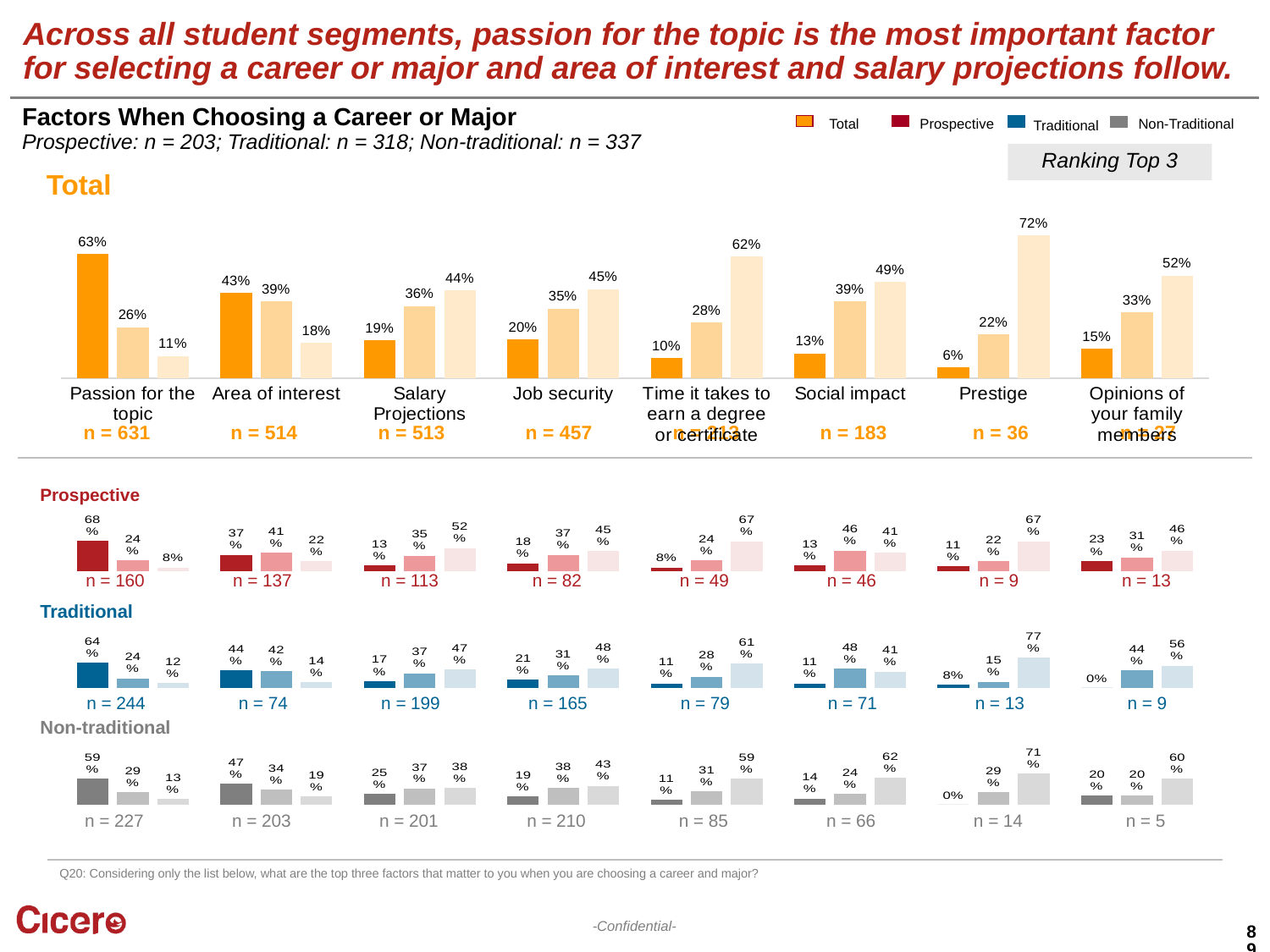
In the Total chart, which is larger: the lightest (third) bar for Prestige or the lightest (third) bar for Social impact? Prestige In the Total chart, which category has the lowest value for its darkest (first) bar? Prestige How many entries does the legend at the top right of the slide list? 4 In the Prospective chart, what is the value of the darkest (first) bar for Passion for the topic? 68% In the Total chart, what is the difference between the darkest (first) bar for Passion for the topic and the darkest (first) bar for Area of interest? 20 percentage points In the Total chart, is the tallest bar for Prestige greater or less than 50%? greater How many factor categories are shown in the Total chart? 8 What kind of chart is used to show the Total results? Bar chart What is the title of the chart on the slide? Factors When Choosing a Career or Major In the Total chart, what is the n value shown under Salary Projections? n = 513 In the Total chart, which category has the highest value for its darkest (first) bar? Passion for the topic In the Total chart, what is the value of the darkest (first) bar for Passion for the topic? 63%